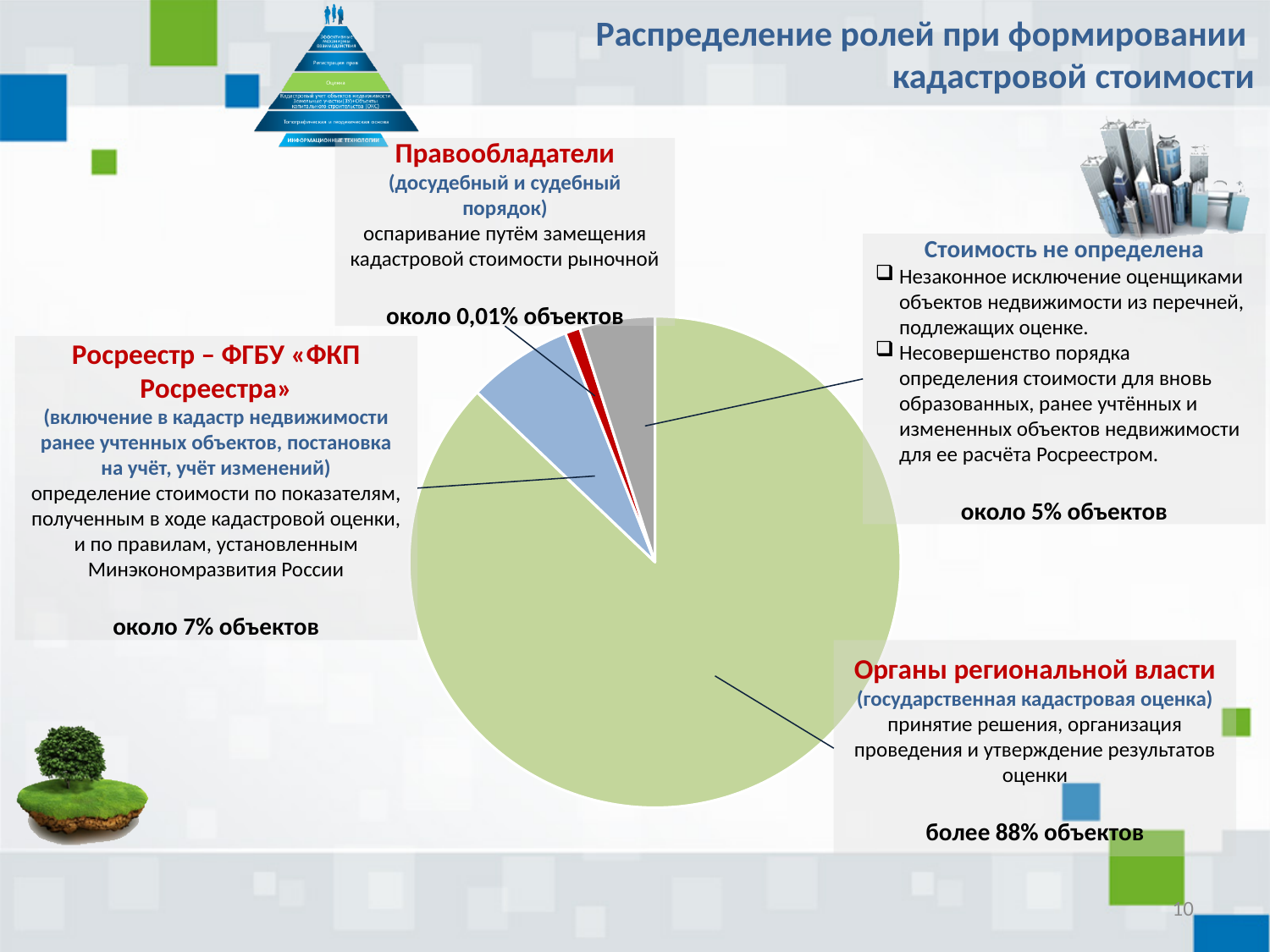
Which group accounts for the largest slice of the pie chart? Органы региональной власти What share of objects does the slide attribute to Органы региональной власти? более 88% объектов How many slices does the pie chart have? 4 What colour is the slice for Правообладатели? Red Is the share for Росреестр – ФГБУ «ФКП Росреестра» greater or less than 25%? less Is the share for Органы региональной власти greater or less than 50%? greater What type of chart is shown on the slide? Pie chart Which slice is larger: the one for Росреестр – ФГБУ «ФКП Росреестра» or the one for Стоимость не определена? Росреестр – ФГБУ «ФКП Росреестра» What colour is the slice for Органы региональной власти? Green Which slice is larger: the one for Правообладатели or the one for Стоимость не определена? Стоимость не определена What share of objects does the slide attribute to Правообладатели? около 0,01% объектов Which group accounts for the smallest slice of the pie chart? Правообладатели